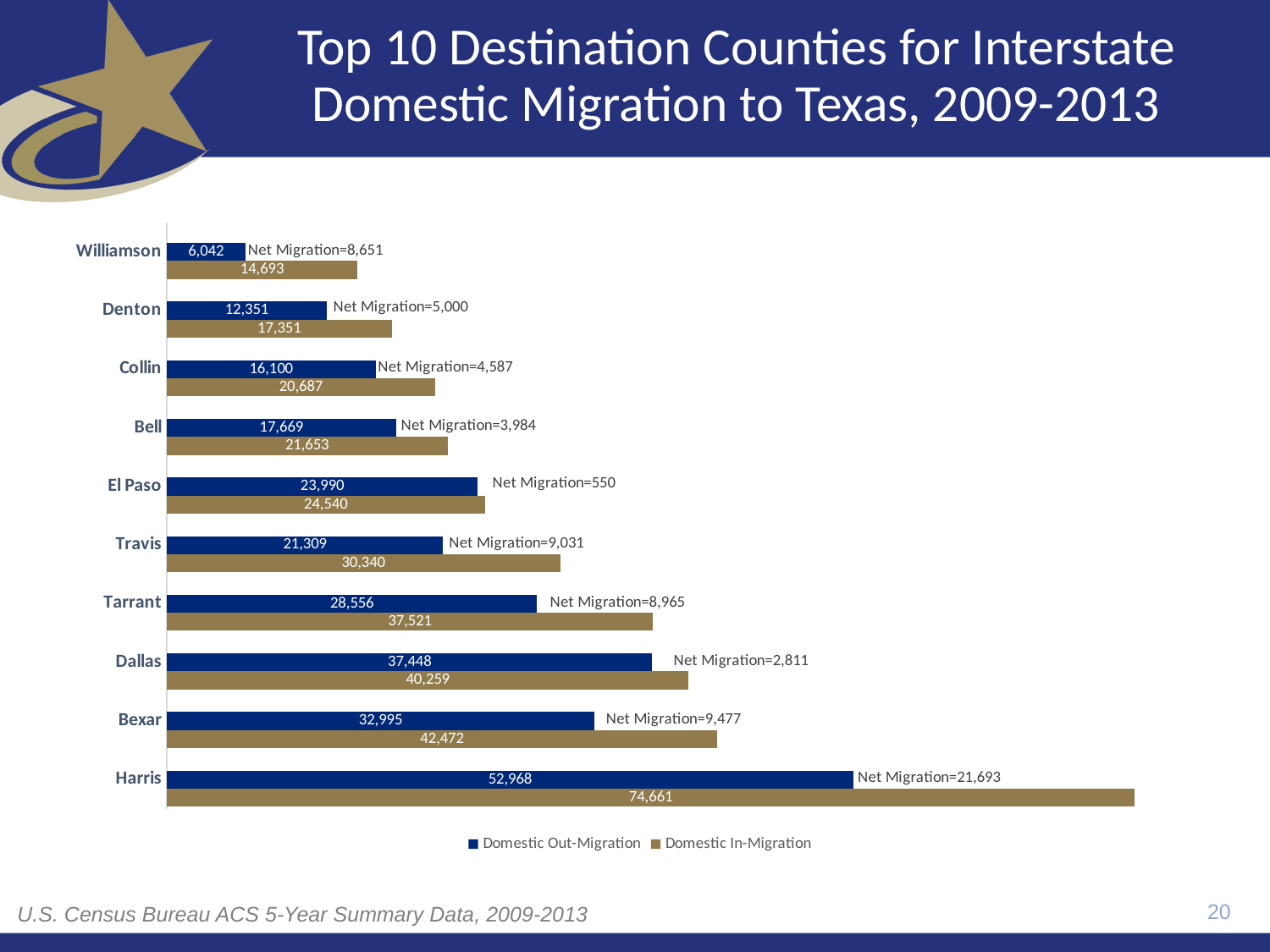
Which is larger, the Domestic Out-Migration for Dallas or for Tarrant? Dallas Which series is shown in gold/tan colour according to the legend? Domestic In-Migration What is the Domestic In-Migration value for Harris? 74,661 How many series does the legend list? 2 What type of chart is shown on the slide? Bar chart Which county has the lowest Domestic Out-Migration value? Williamson What net migration figure is shown for Williamson? Net Migration=8,651 What is the Domestic Out-Migration value for Bexar? 32,995 What is the difference between Domestic In-Migration and Domestic Out-Migration for Dallas? 2,811 What is the Domestic In-Migration value for Travis? 30,340 Which county has the highest Domestic In-Migration value? Harris How many counties are shown on the chart? 10